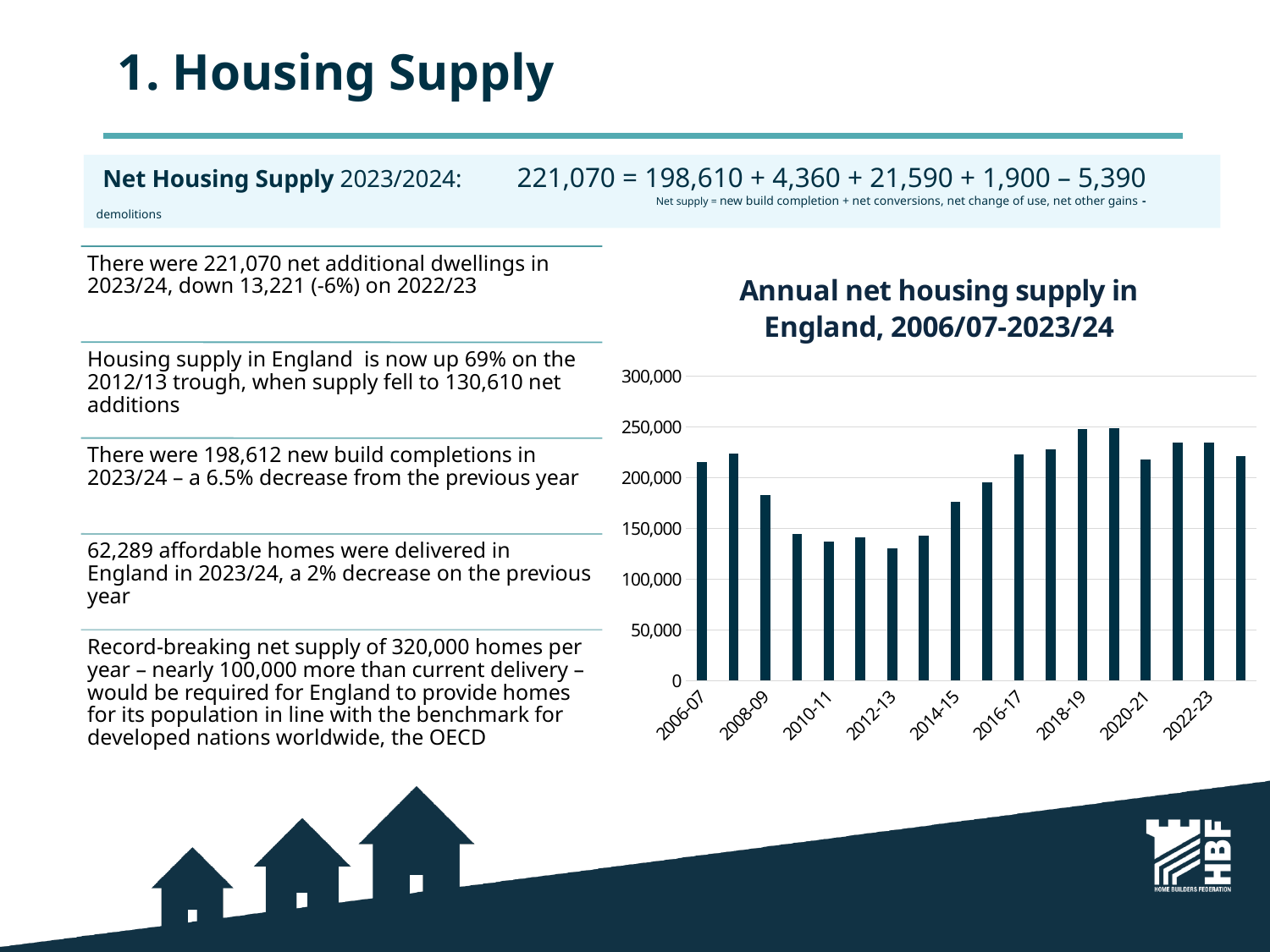
Is the value for 2010-11 greater or less than 150,000? less What is the title of the chart? Annual net housing supply in England, 2006/07-2023/24 Is the value for 2006-07 greater or less than 200,000? greater Do the values generally rise or fall from 2012-13 to 2018-19? rise Which year has the lowest net housing supply in the chart? 2012-13 How many bars are plotted in the chart? 18 What kind of chart is shown on the slide? bar chart Which is larger, the value for 2016-17 or the value for 2012-13? 2016-17 Which is larger, the value for 2008-09 or the value for 2010-11? 2008-09 Is the value for 2012-13 greater or less than 150,000? less